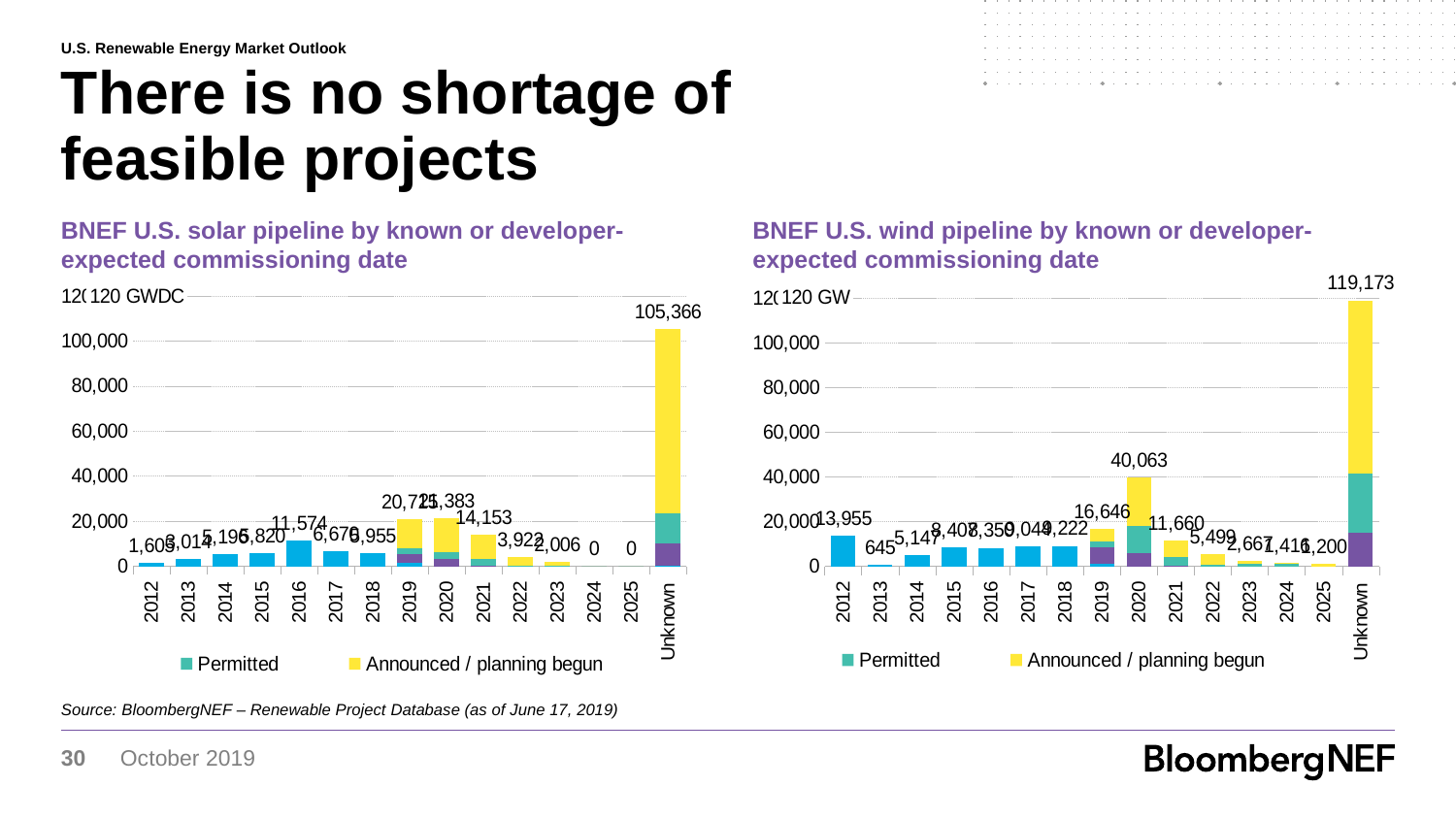
What kind of chart is the BNEF U.S. solar pipeline chart? Stacked bar chart What is the difference between the Unknown bar in the wind pipeline chart (119,173) and the Unknown bar in the solar pipeline chart (105,366)? 13,807 In the BNEF U.S. wind pipeline chart, which is larger, the value for 2019 or the value for 2021? 2019 In the BNEF U.S. wind pipeline chart, which year has the lowest labelled value? 2013 In the BNEF U.S. wind pipeline chart, which category has the highest value? Unknown In the BNEF U.S. wind pipeline chart, what is the total value labelled for the Unknown commissioning date bar? 119,173 In the BNEF U.S. solar pipeline chart, what is the total value labelled for the Unknown commissioning date bar? 105,366 How many series does the legend of the BNEF U.S. wind pipeline chart list? 2 In the BNEF U.S. wind pipeline chart, what is the value labelled for 2020? 40,063 How many categories are shown on the x axis of the BNEF U.S. solar pipeline chart? 15 In the BNEF U.S. solar pipeline chart, is the value for 2016 greater or less than 20,000? less In the BNEF U.S. solar pipeline chart, what is the value labelled for 2016? 11,574